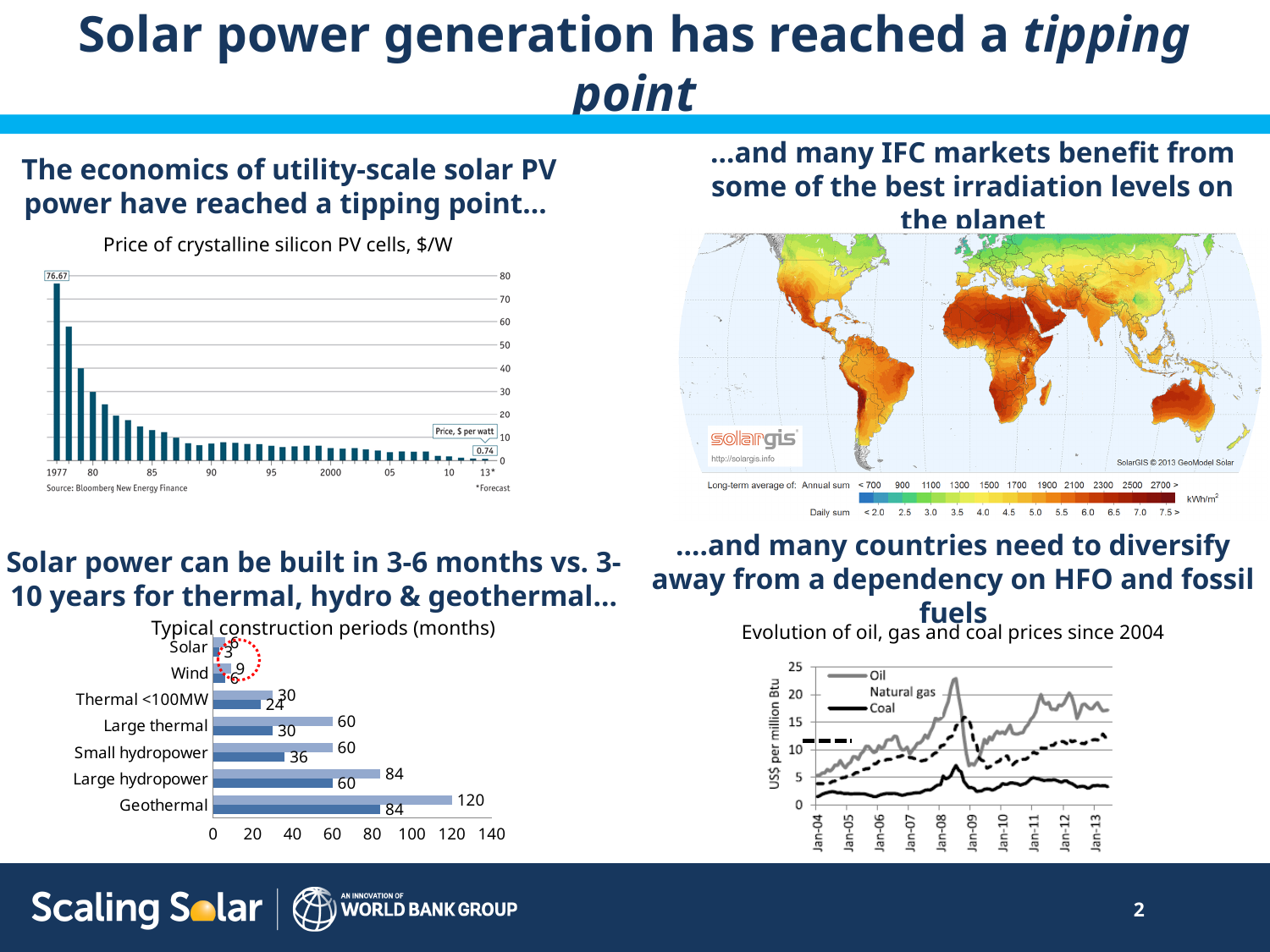
In the 'Typical construction periods (months)' chart, which category has the longest construction period? Geothermal In the 'Price of crystalline silicon PV cells, $/W' chart, what is the price shown for 1977? 76.67 In the 'Evolution of oil, gas and coal prices since 2004' chart, is the peak value of Oil around 2008 greater or less than 20? greater In the 'Typical construction periods (months)' chart, what is the difference between the longer period for Large hydropower (84) and the longer period for Large thermal (60)? 24 In the 'Typical construction periods (months)' chart, what is the longer construction period shown for Geothermal? 120 In the 'Price of crystalline silicon PV cells, $/W' chart, do prices rise or fall from 1977 to 2013? fall In the 'Typical construction periods (months)' chart, which category has the shortest construction period? Solar In the 'Typical construction periods (months)' chart, what is the shorter construction period shown for Solar? 3 How many series does the legend list in the 'Evolution of oil, gas and coal prices since 2004' chart? 3 In the 'Typical construction periods (months)' chart, how many categories are listed on the vertical axis? 7 In the 'Price of crystalline silicon PV cells, $/W' chart, what is the forecast price shown for 2013? 0.74 In the 'Typical construction periods (months)' chart, which has a longer maximum construction period, Wind or Thermal <100MW? Thermal <100MW